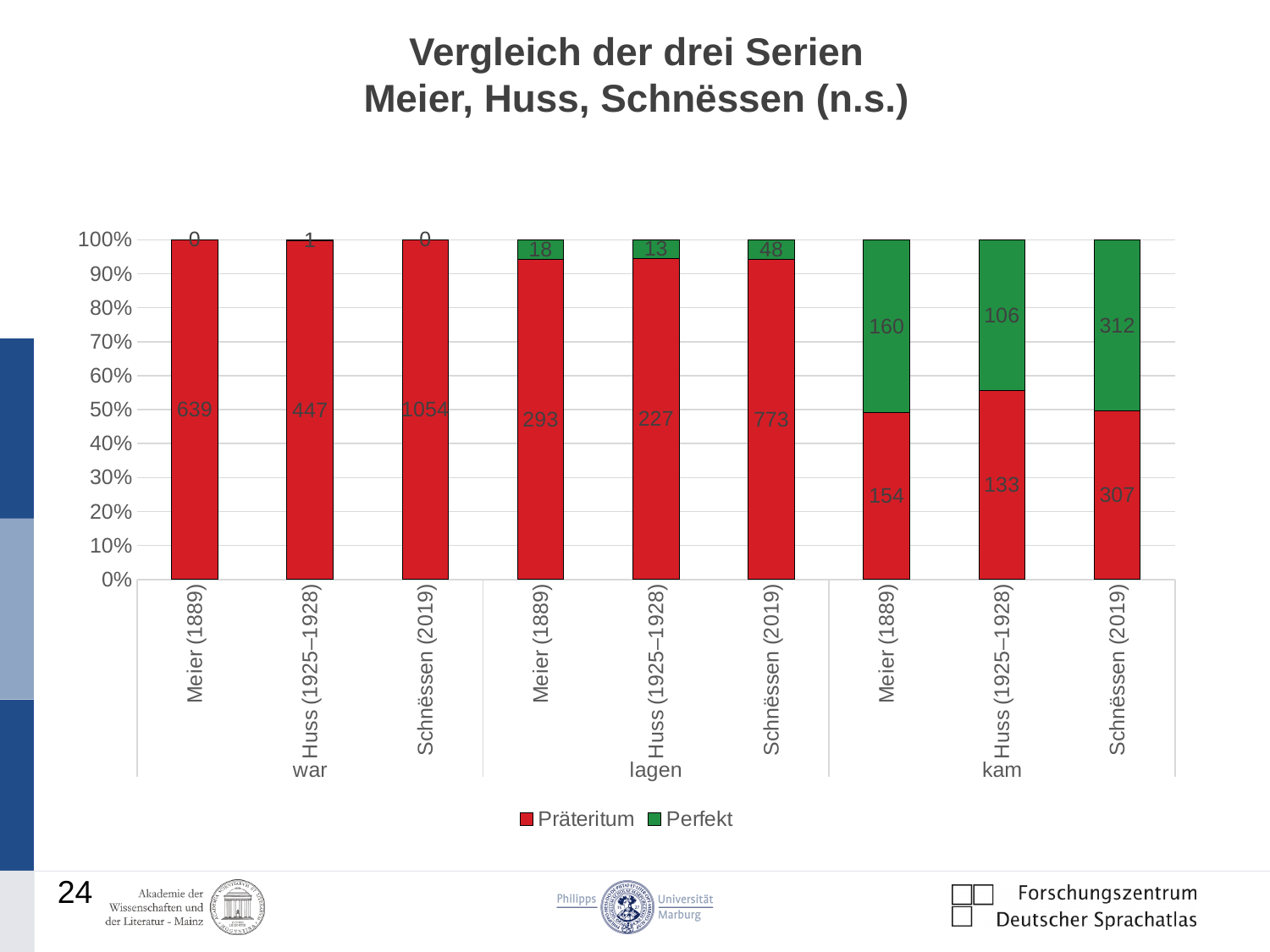
What is the Perfekt count for Meier (1889) in the 'kam' group? 160 What is the difference between the Perfekt and Präteritum counts for Schnëssen (2019) in the 'kam' group? 5 What is the Präteritum count for Schnëssen (2019) in the 'war' group? 1054 What is the total count (Präteritum plus Perfekt) for Meier (1889) in the 'kam' group? 314 How many series does the legend list? 2 Which bar has the lowest Präteritum count? Huss (1925–1928), kam What is the Perfekt count for Schnëssen (2019) in the 'lagen' group? 48 Is the Präteritum share for Meier (1889) in the 'lagen' group greater or less than 90%? greater What is the Präteritum count for Huss (1925–1928) in the 'war' group? 447 What type of chart is shown? stacked bar chart Which bar has the highest Präteritum count? Schnëssen (2019), war In the 'kam' group, is the Präteritum count for Huss (1925–1928) larger or smaller than its Perfekt count? larger